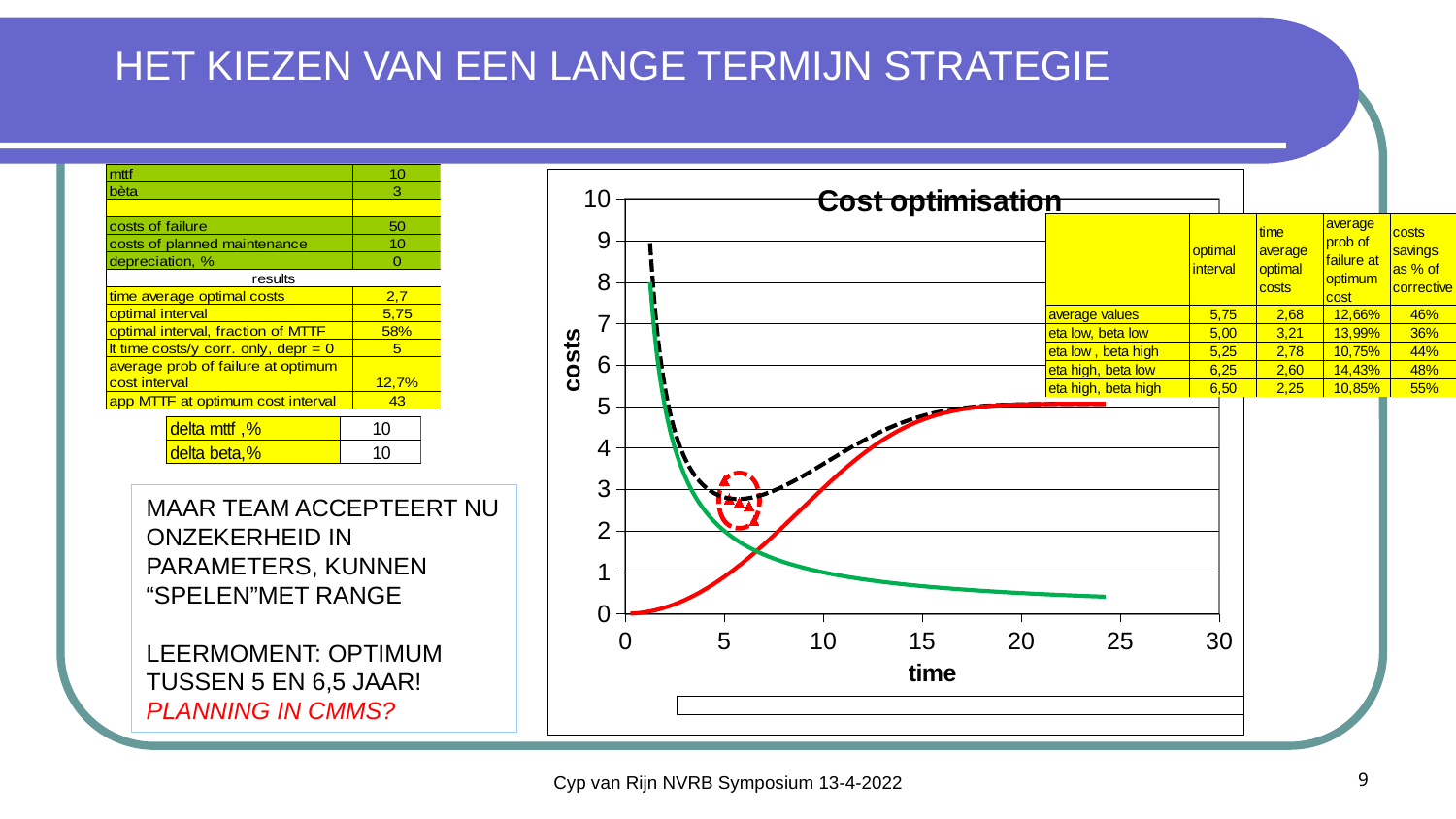
In the "Cost optimisation" chart, does the green line rise or fall as time increases? fall In the "Cost optimisation" chart, is the value of the black dashed line at time 5 greater or less than 4? less What kind of chart is the "Cost optimisation" chart? line chart What is the label on the vertical axis of the "Cost optimisation" chart? costs What is the highest tick value shown on the time axis of the "Cost optimisation" chart? 30 In the "Cost optimisation" chart, is the value of the red line at time 20 greater or less than 4? greater In the "Cost optimisation" chart, is the value of the green line at time 20 greater or less than 1? less What is the title of the chart on the slide? Cost optimisation In the "Cost optimisation" chart, at time 5, which line is higher: the green line or the red line? green line In the "Cost optimisation" chart, does the red line rise or fall as time increases? rise How many lines are plotted in the "Cost optimisation" chart? 3